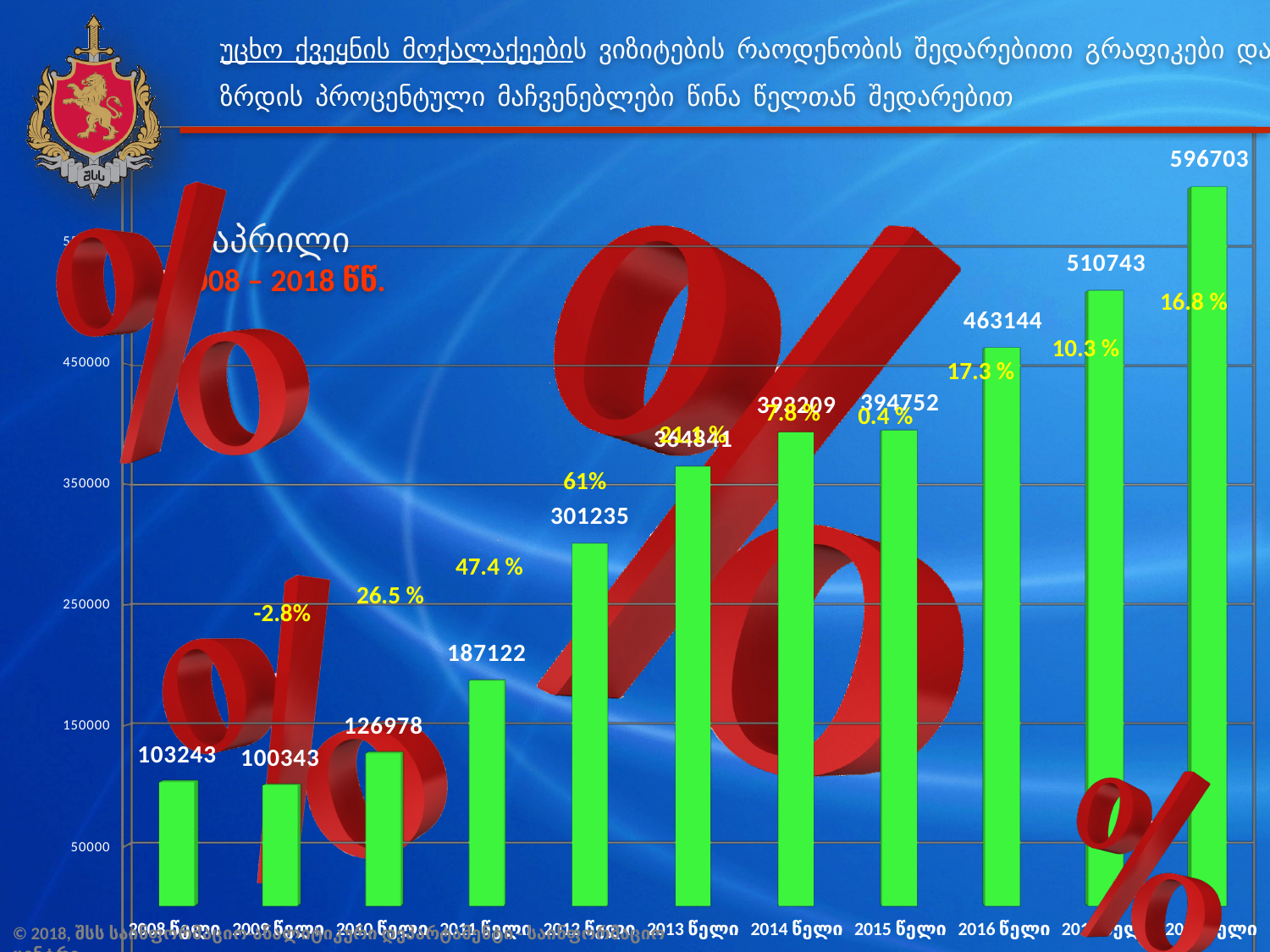
Which is larger, the value for 2010 or the value for 2011? 2011 What is the value shown for 2008 (2008 წელი)? 103243 What is the value shown for 2011 (2011 წელი)? 187122 What percentage growth label is shown for 2016? 17.3 % Which year has the lowest bar? 2009 (100343) What is the difference between the 2012 value and the 2011 value? 114113 What percentage growth label is shown above the 2009 bar? -2.8% What type of chart is shown on the slide? bar chart What is the value shown for 2016 (2016 წელი)? 463144 How many bars (years) are plotted in the chart? 11 Is the value for 2012 greater or less than 350000? less Which year has the highest bar? 2018 (596703)